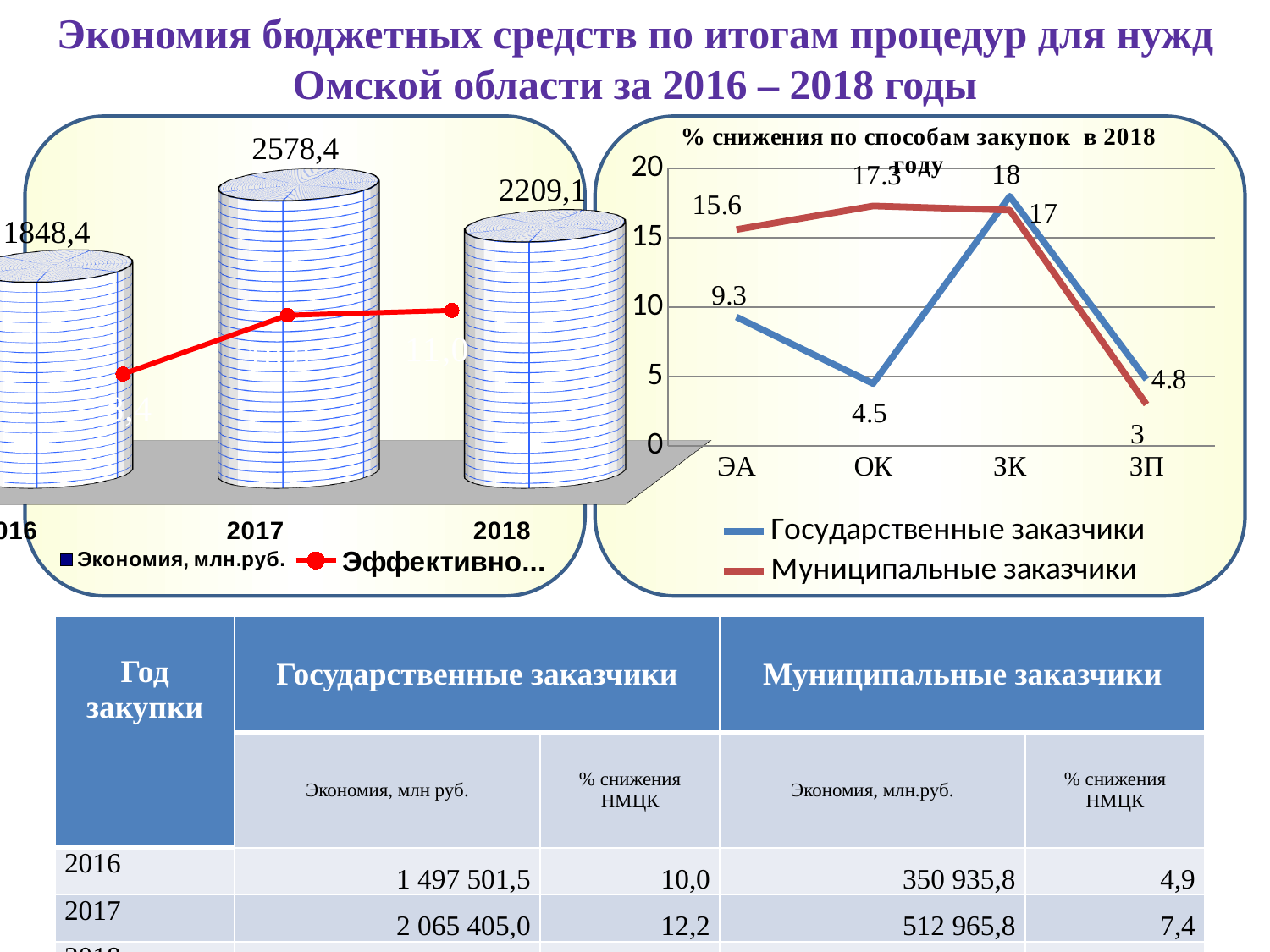
In the chart '% снижения по способам закупок в 2018 году', at which category is the value for Государственные заказчики highest? ЗК In the chart '% снижения по способам закупок в 2018 году', how many series does the legend list? 2 In the chart '% снижения по способам закупок в 2018 году', what is the value for Муниципальные заказчики at ЭА? 15.6 In the chart '% снижения по способам закупок в 2018 году', what is the value for Государственные заказчики at ОК? 4.5 In the left chart, how many years are shown on the x axis? 3 In the left chart, which year has the highest Экономия, млн.руб.? 2017 In the left chart, what is the value of Экономия, млн.руб. for 2017? 2578,4 In the chart '% снижения по способам закупок в 2018 году', at which category is the value for Муниципальные заказчики lowest? ЗП In the left chart, what is the difference between the Экономия, млн.руб. values for 2017 and 2016? 730,0 In the chart '% снижения по способам закупок в 2018 году', which series has the larger value at ОК? Муниципальные заказчики In the left chart, which year has the lowest Экономия, млн.руб.? 2016 What kind of chart is the chart '% снижения по способам закупок в 2018 году'? line chart